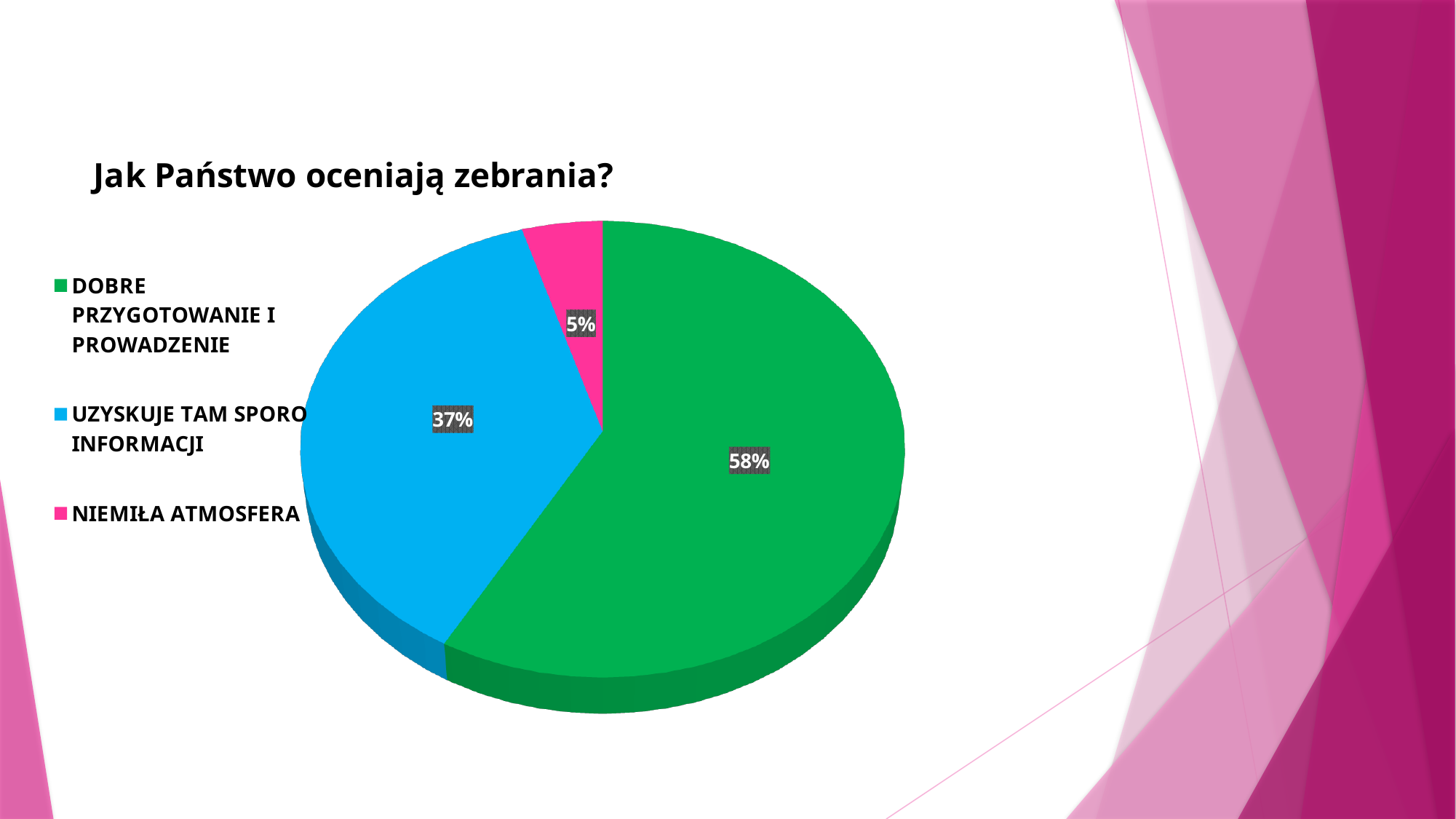
What share of the pie does UZYSKUJE TAM SPORO INFORMACJI have? 37% Which is larger: the share for UZYSKUJE TAM SPORO INFORMACJI or the share for NIEMIŁA ATMOSFERA? UZYSKUJE TAM SPORO INFORMACJI What is the title of the chart? Jak Państwo oceniają zebrania? How many categories are shown in the pie chart? 3 Which category has the smallest slice of the pie? NIEMIŁA ATMOSFERA What is the difference in percentage points between DOBRE PRZYGOTOWANIE I PROWADZENIE and UZYSKUJE TAM SPORO INFORMACJI? 21 percentage points What share of the pie does NIEMIŁA ATMOSFERA have? 5% What is the difference in percentage points between UZYSKUJE TAM SPORO INFORMACJI and NIEMIŁA ATMOSFERA? 32 percentage points What share of the pie does DOBRE PRZYGOTOWANIE I PROWADZENIE have? 58% What kind of chart is shown on the slide? Pie chart What colour is the slice for NIEMIŁA ATMOSFERA? Pink Which category has the largest slice of the pie? DOBRE PRZYGOTOWANIE I PROWADZENIE